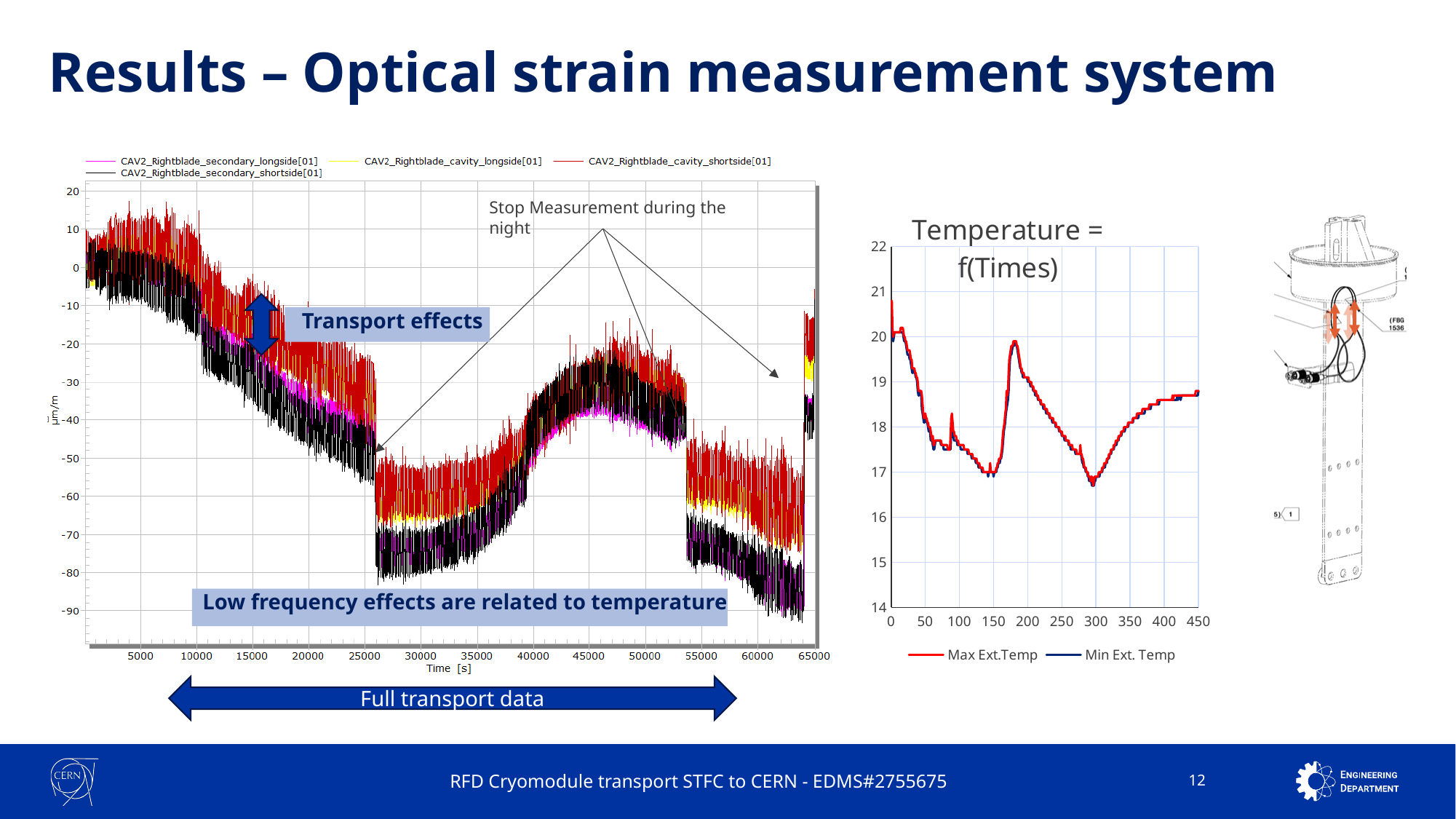
In the 'Temperature = f(Times)' chart, does the temperature rise or fall between x = 300 and x = 450? rise In the 'Temperature = f(Times)' chart, which series is drawn in red? Max Ext.Temp How many series does the legend of the 'Temperature = f(Times)' chart list? 2 What kind of chart is the large strain chart on the left of the slide? line chart In the 'Temperature = f(Times)' chart, does the temperature rise or fall between x = 0 and x = 150? fall How many series does the legend of the left strain chart list? 4 What is the highest value shown on the y axis of the 'Temperature = f(Times)' chart? 22 What kind of chart is the 'Temperature = f(Times)' chart on the right? line chart In the left strain chart, is the strain at 30000 s greater or less than -50 µm/m? less In the 'Temperature = f(Times)' chart, is the temperature at x = 0 greater or less than 19? greater In the 'Temperature = f(Times)' chart, is the temperature at x = 180 greater or less than 19? greater In the left strain chart, does the strain rise or fall between 5000 s and 25000 s? fall